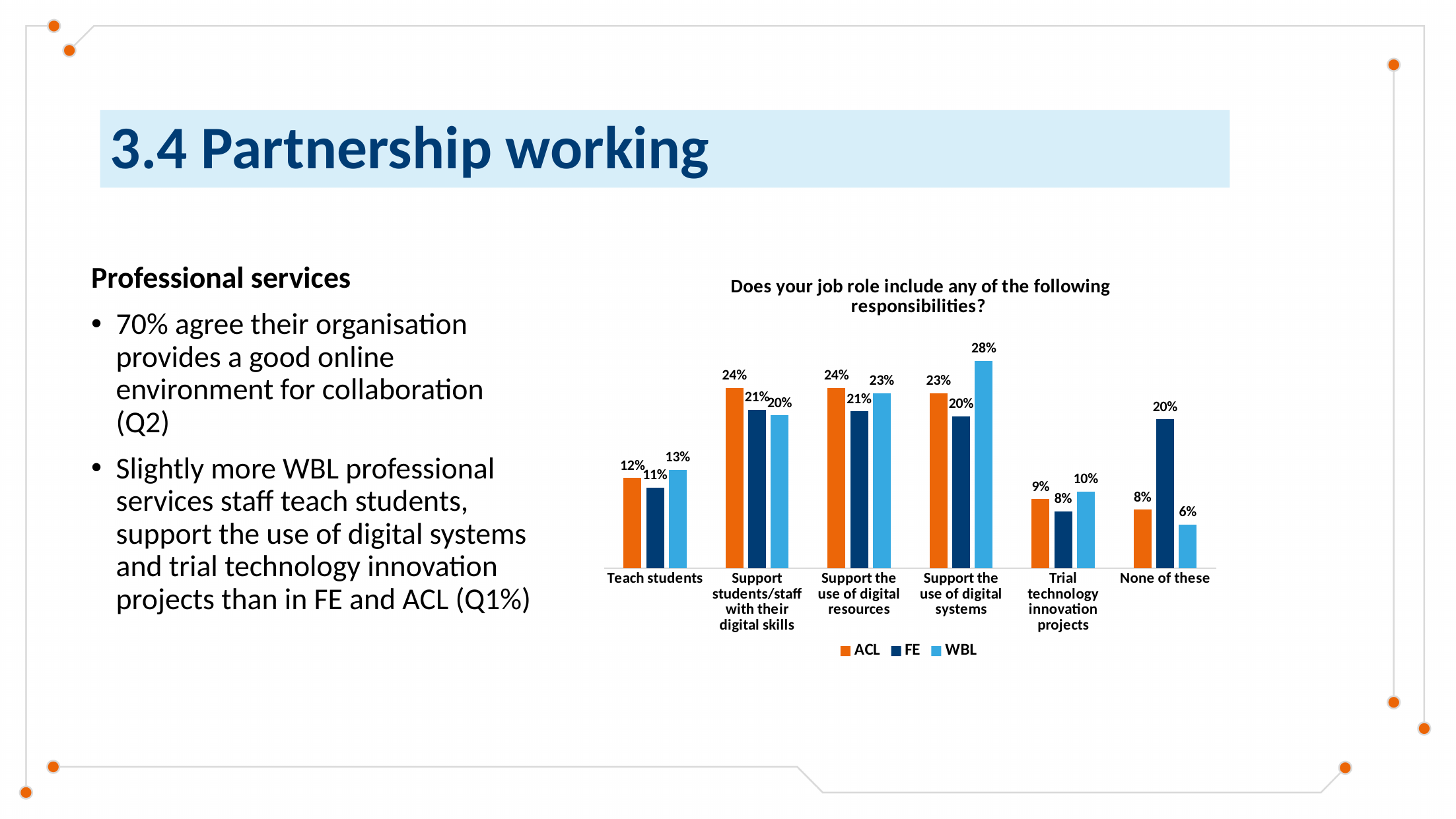
How many categories are shown on the x axis? 6 Which category has the lowest WBL value? None of these How many series does the legend list? 3 What is the WBL value for "Support the use of digital systems"? 28% Which category has the highest WBL value? Support the use of digital systems Which series is shown in orange in the legend? ACL What is the title of the chart? Does your job role include any of the following responsibilities? What is the difference between the FE and WBL values for "None of these"? 14% Which is larger for "Support the use of digital systems": the ACL value or the WBL value? WBL What is the FE value for "None of these"? 20% What is the ACL value for "Teach students"? 12% What kind of chart is shown on the slide? Bar chart